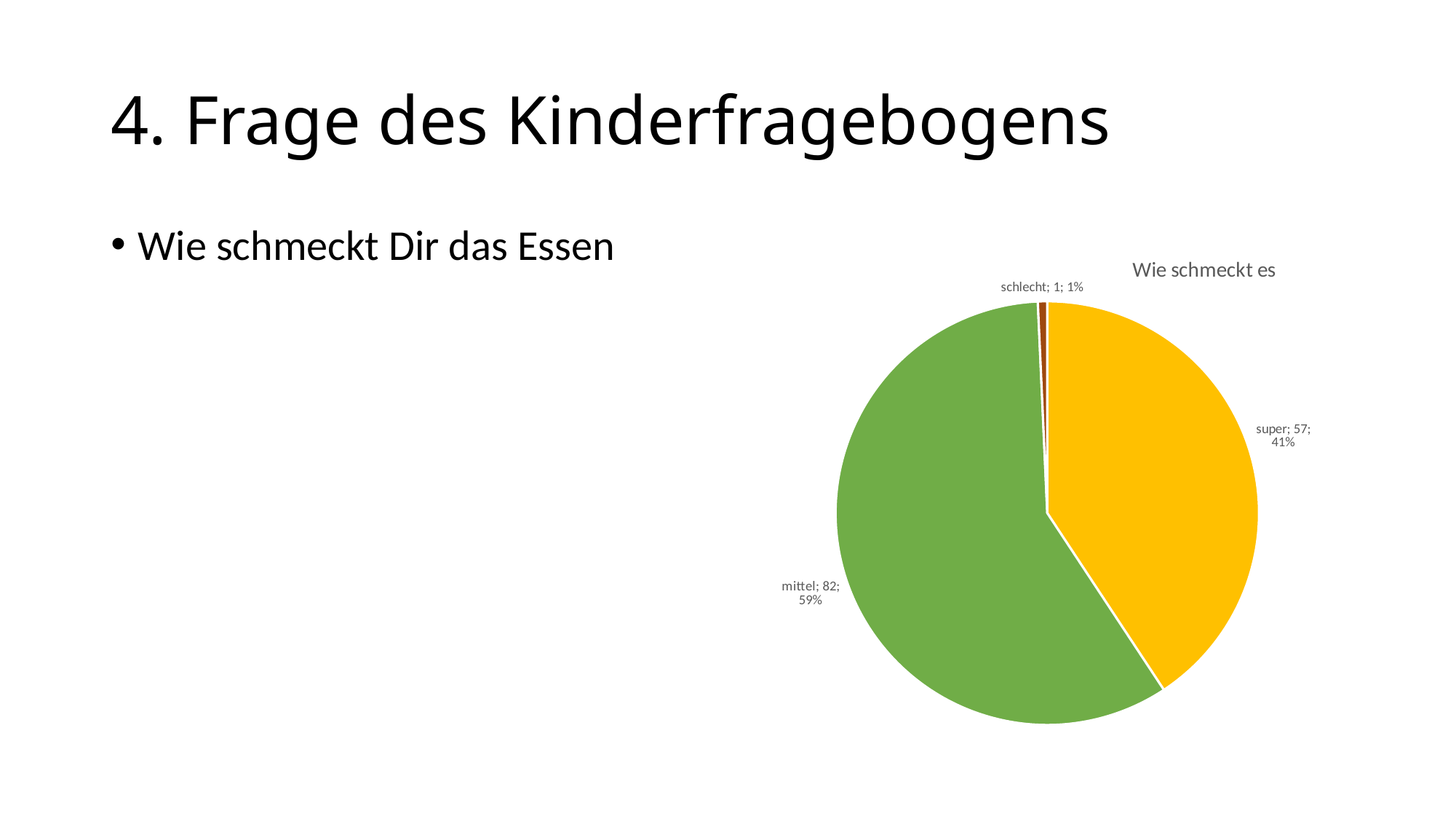
Which category has the largest slice? mittel What is the difference between the counts for 'mittel' and 'super'? 25 What is the title of the chart? Wie schmeckt es What share of the pie does 'super' represent? 41% What is the count for the 'super' slice? 57 Which slice is larger, 'super' or 'schlecht'? super Which category has the smallest slice? schlecht What is the count for the 'schlecht' slice? 1 What share of the pie does 'mittel' represent? 59% What kind of chart is shown on the slide? pie chart What is the count for the 'mittel' slice? 82 How many slices does the pie chart have? 3